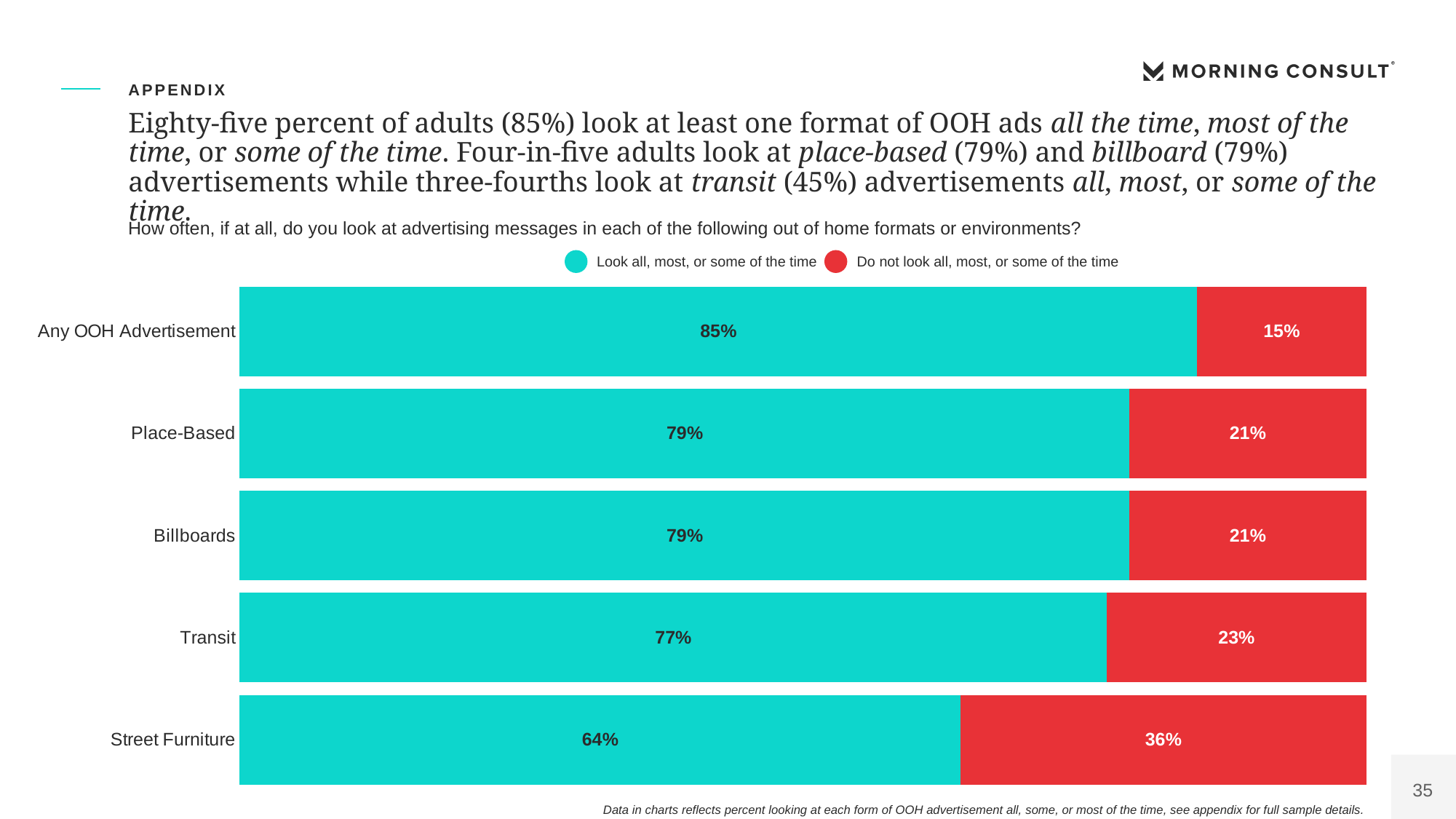
How many categories are shown in the chart? 5 How many series does the legend list? 2 Which category has the lowest 'Look all, most, or some of the time' value? Street Furniture What percentage of adults look at Any OOH Advertisement all, most, or some of the time? 85% Which category has the highest 'Do not look all, most, or some of the time' value? Street Furniture What is the total of the two segments in the Billboards bar? 100% Which is larger: the 'Look all, most, or some of the time' value for Transit or for Street Furniture? Transit What kind of chart is shown on the slide? Stacked bar chart What percentage of adults do not look at Street Furniture advertisements all, most, or some of the time? 36% What is the difference between the 'Look all, most, or some of the time' values for Any OOH Advertisement and Street Furniture? 21 percentage points Which colour represents 'Do not look all, most, or some of the time' in the legend? Red What is the 'Look all, most, or some of the time' value for Transit? 77%